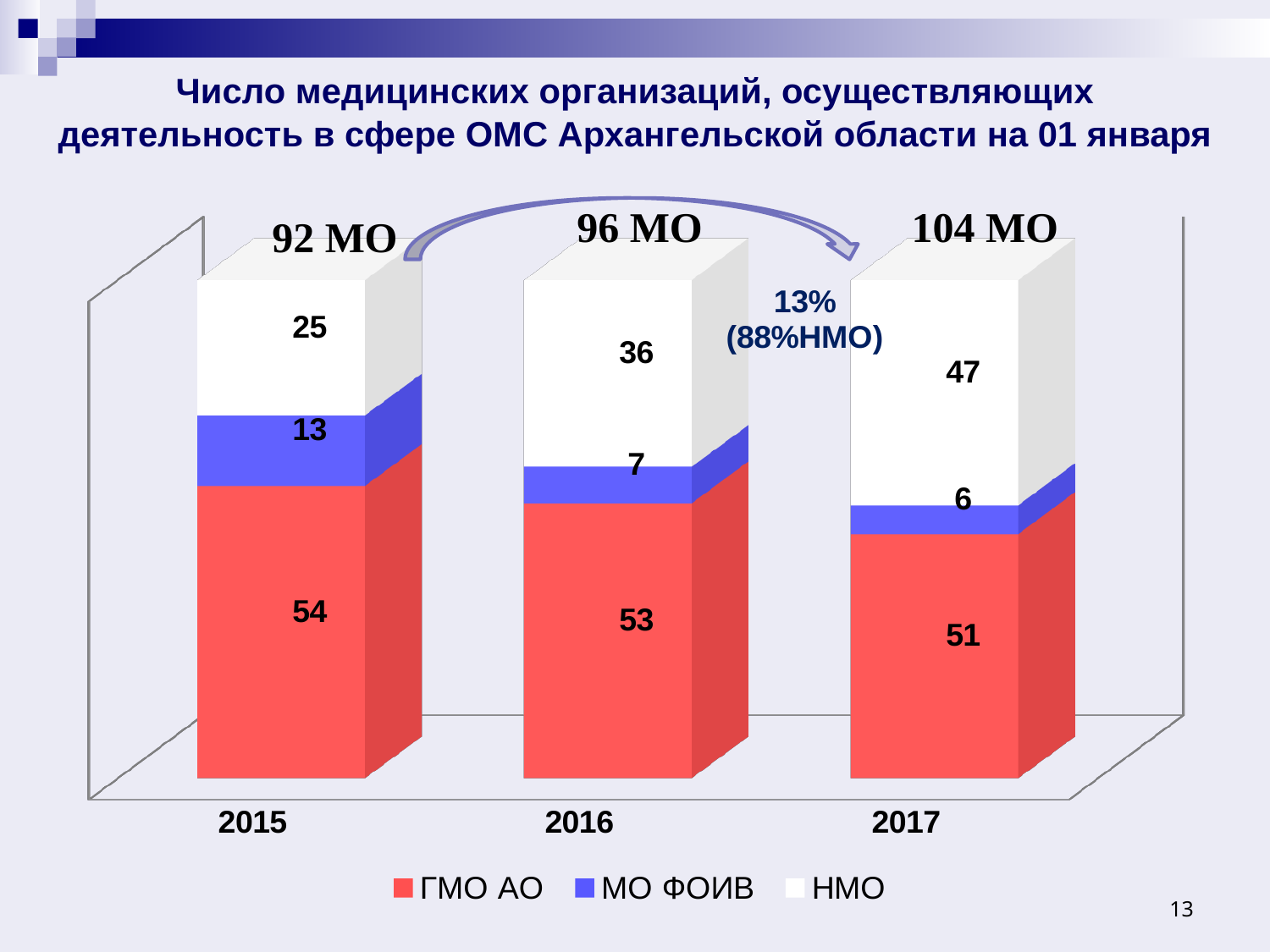
In which year is the МО ФОИВ value lowest? 2017 What is the value for МО ФОИВ in 2016? 7 What is the value for ГМО АО in 2015? 54 What is the value for НМО in 2017? 47 How many years are shown on the x axis? 3 What kind of chart is shown on the slide? stacked bar chart What is the total of the stacked bar for 2016? 96 How many series does the legend list? 3 What is the difference between the НМО values for 2017 and 2015? 22 In which year is the НМО value highest? 2017 Which is larger, the ГМО АО value in 2015 or in 2017? 2015 Does the НМО value rise or fall from 2015 to 2017? rise